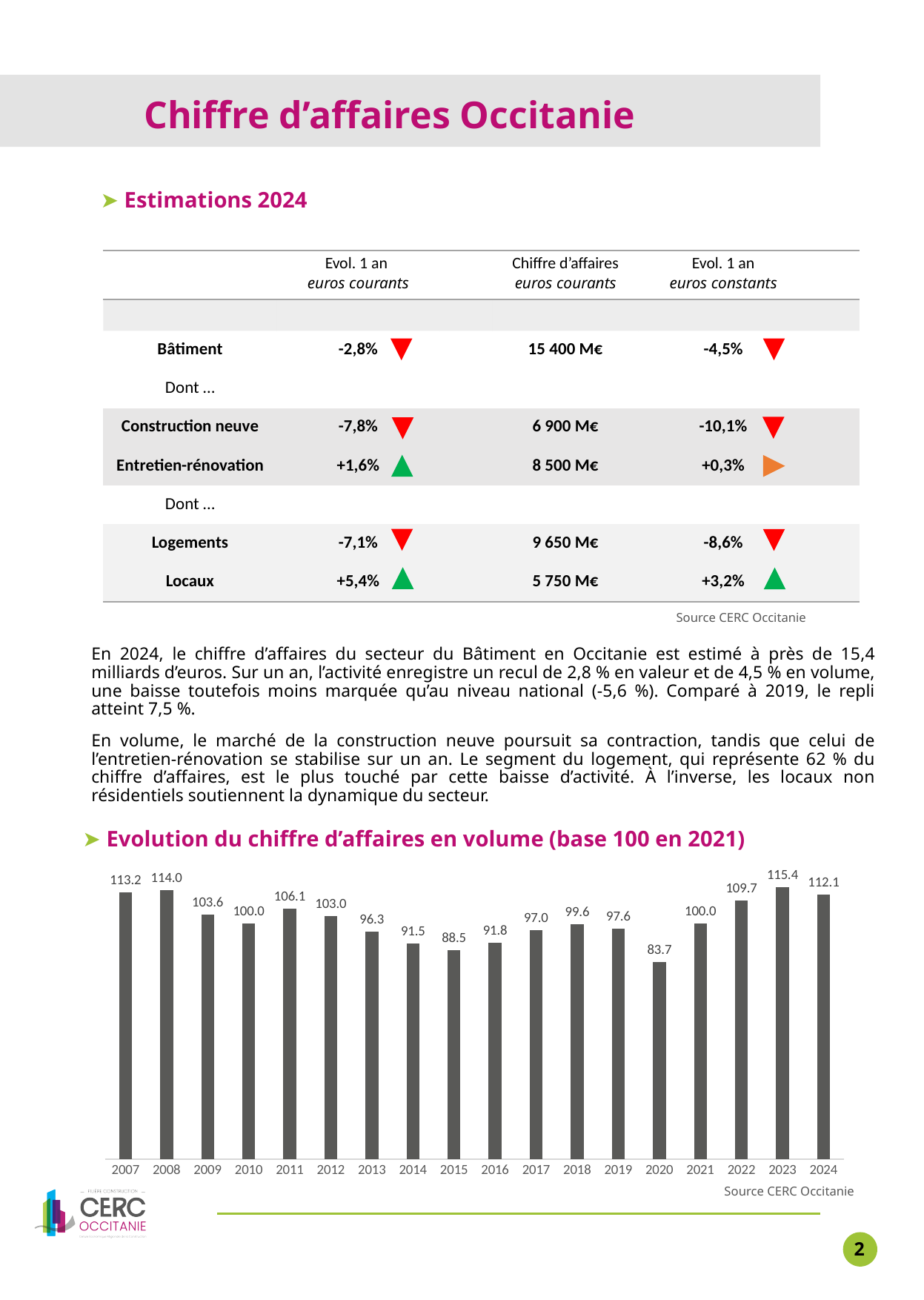
What is the title of the chart? Evolution du chiffre d'affaires en volume (base 100 en 2021) Which is larger, the value for 2022 or the value for 2024? 2024 Which year has the lowest value in the chart? 2020 What is the difference between the values for 2021 and 2020? 16.3 Do the values rise or fall from 2020 to 2023? Rise What is the difference between the values for 2023 and 2024? 3.3 What kind of chart is shown under 'Evolution du chiffre d'affaires en volume (base 100 en 2021)'? Bar chart What is the value for 2020 in the chart? 83.7 What is the value for 2023 in the chart? 115.4 How many years are plotted in the chart? 18 Which year has the highest value in the chart? 2023 What is the value for 2024 in the chart? 112.1